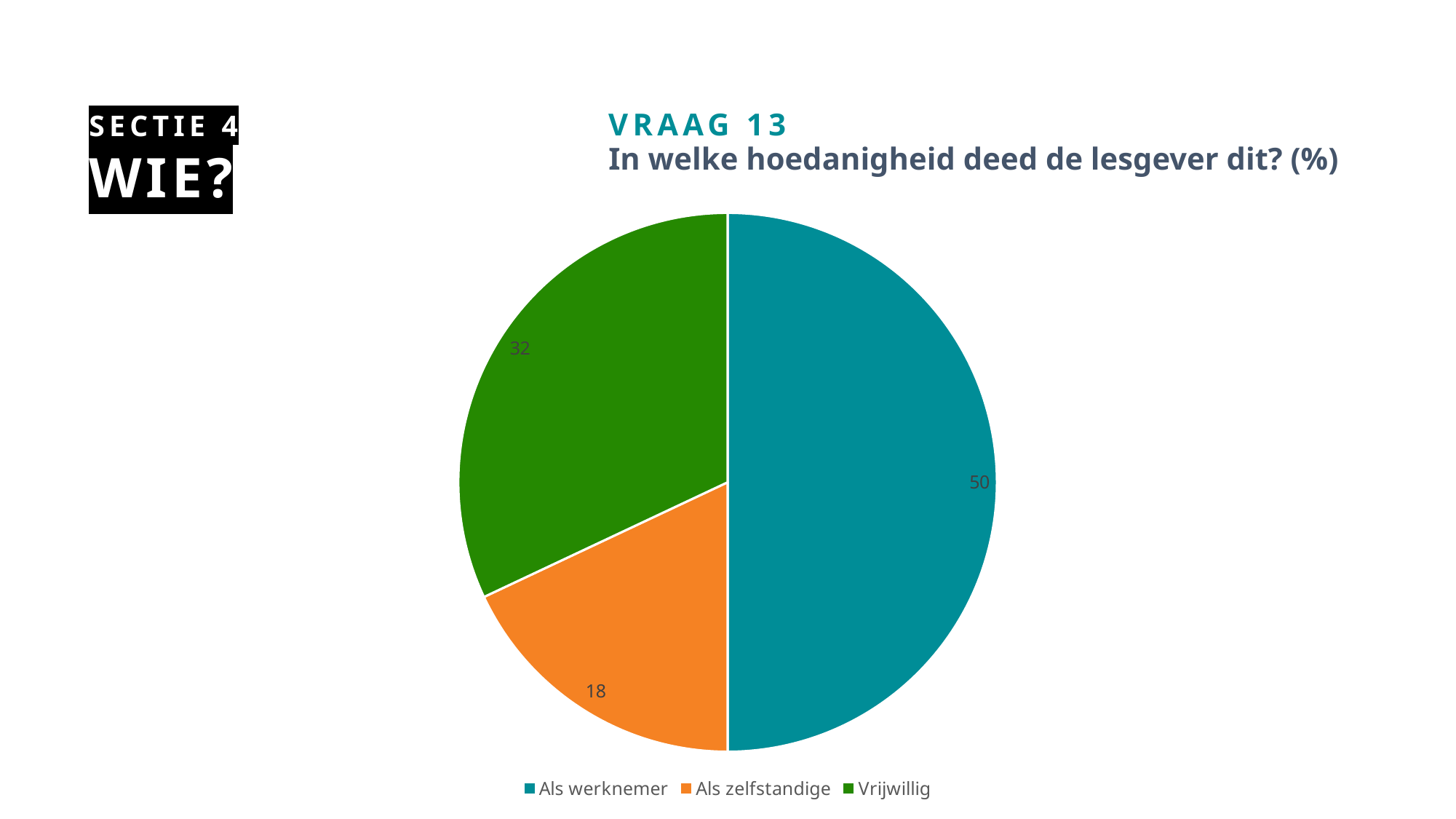
What colour is the Vrijwillig slice? Green What is the difference between the values for Vrijwillig and Als zelfstandige? 14 What kind of chart is shown on the slide? Pie chart What is the difference between the values for Als werknemer and Vrijwillig? 18 What is the value for Als werknemer? 50 What is the value for Vrijwillig? 32 What is the value for Als zelfstandige? 18 Which category has the smallest slice? Als zelfstandige Which category has the largest slice? Als werknemer What share of the pie does Als werknemer represent? 50% Which is larger, Vrijwillig or Als zelfstandige? Vrijwillig How many slices does the pie chart have? 3